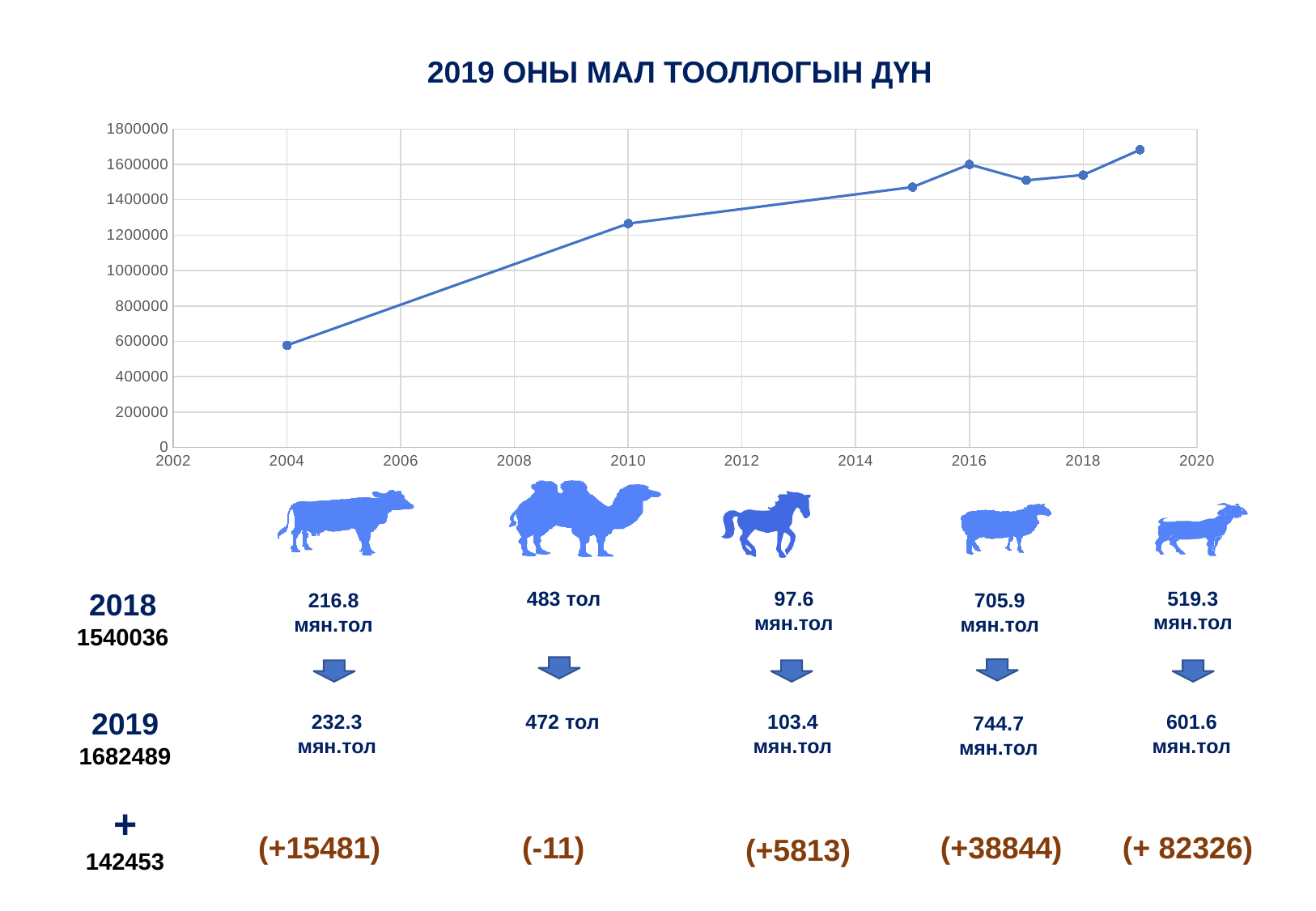
Which year has the highest value on the chart? 2019 What kind of chart is shown on the slide? line chart Which year has the larger value, 2016 or 2017? 2016 Is the value for 2004 greater or less than 800000? less What is the title of the chart? 2019 ОНЫ МАЛ ТООЛЛОГЫН ДҮН Is the value for 2010 greater or less than 1200000? greater What is the highest value shown on the y axis? 1800000 Is the value for 2015 greater or less than 1400000? greater How many data points are plotted on the line? 7 Do the values generally rise or fall from 2004 to 2019? rise Which year has the lowest value on the chart? 2004